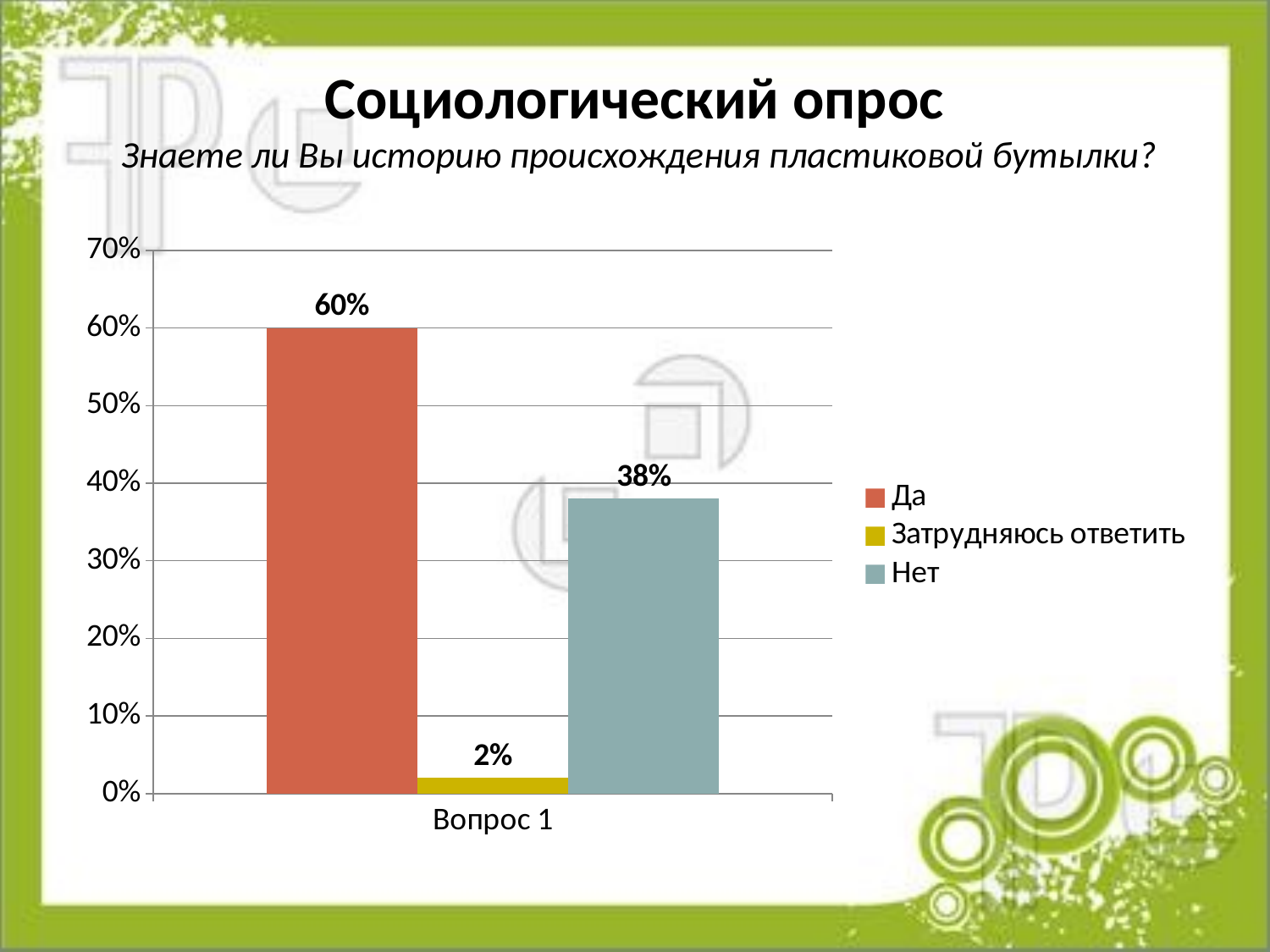
What colour is the bar for "Да"? red (orange-red) Which series has the lowest value? Затрудняюсь ответить How many series does the legend list? 3 What kind of chart is shown on the slide? bar chart What is the category label on the x axis? Вопрос 1 What is the difference between the values for "Да" and "Нет"? 22% What is the value for "Нет"? 38% What is the value for "Затрудняюсь ответить"? 2% Which is larger, the value for "Нет" or the value for "Затрудняюсь ответить"? Нет Is the value for "Нет" greater or less than 40%? less Which series has the highest value? Да What is the value for "Да"? 60%